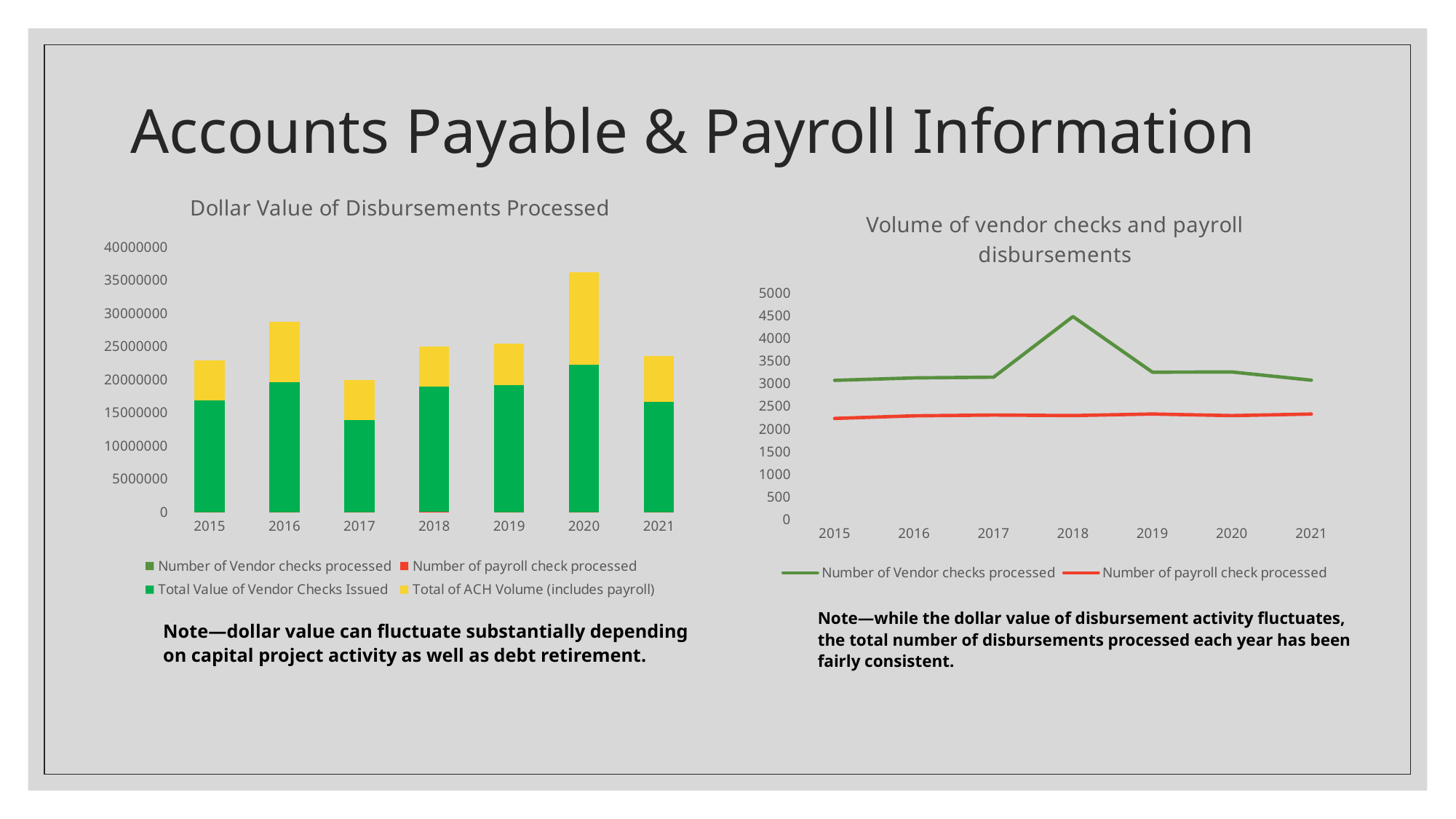
In the 'Dollar Value of Disbursements Processed' chart, which year has the shortest stacked bar? 2017 In the 'Volume of vendor checks and payroll disbursements' chart, which series is larger in 2018: Number of Vendor checks processed or Number of payroll check processed? Number of Vendor checks processed What kind of chart is the 'Volume of vendor checks and payroll disbursements' chart? line chart What kind of chart is the 'Dollar Value of Disbursements Processed' chart? bar chart In the 'Dollar Value of Disbursements Processed' chart, which year has the tallest stacked bar? 2020 In the 'Volume of vendor checks and payroll disbursements' chart, is the value for Number of Vendor checks processed in 2018 greater or less than 4000? greater In the 'Dollar Value of Disbursements Processed' chart, is the total stacked value for 2020 greater or less than 30000000? greater In the 'Volume of vendor checks and payroll disbursements' chart, does the Number of Vendor checks processed rise or fall from 2018 to 2021? fall In the 'Dollar Value of Disbursements Processed' chart, how many years are shown on the x axis? 7 How many series does the legend of the 'Volume of vendor checks and payroll disbursements' chart list? 2 In the 'Dollar Value of Disbursements Processed' chart, is the total stacked value for 2017 greater or less than 25000000? less In the 'Volume of vendor checks and payroll disbursements' chart, which year has the highest value for Number of Vendor checks processed? 2018